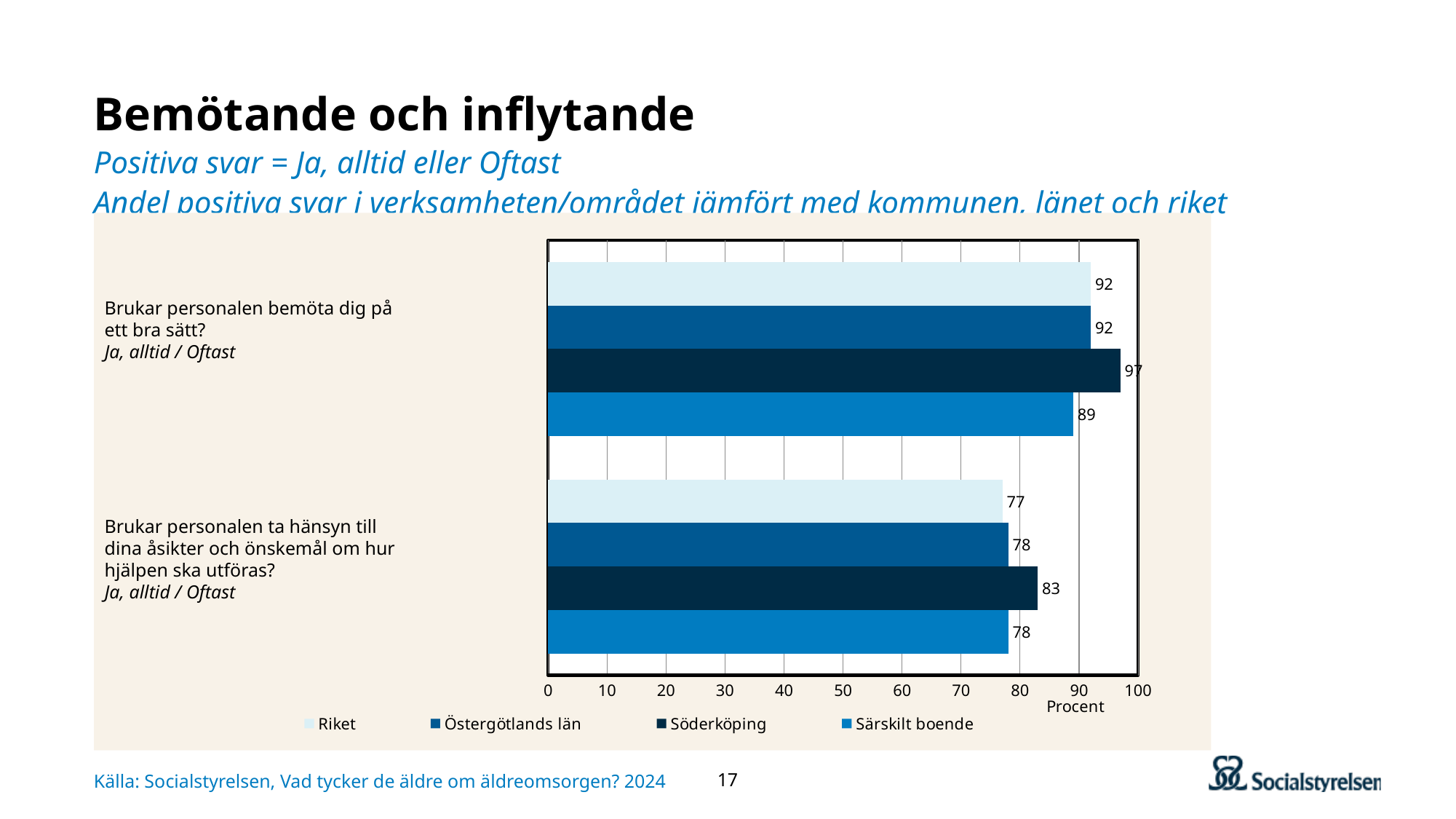
Which is larger on "Brukar personalen ta hänsyn till dina åsikter och önskemål om hur hjälpen ska utföras?": Söderköping or Östergötlands län? Söderköping What is the value for Söderköping on "Brukar personalen bemöta dig på ett bra sätt?" 97 Which series has the highest value on "Brukar personalen bemöta dig på ett bra sätt?" Söderköping What is the value for Riket on "Brukar personalen ta hänsyn till dina åsikter och önskemål om hur hjälpen ska utföras?" 77 What unit is shown on the x axis of the chart? Procent What is the value for Söderköping on "Brukar personalen ta hänsyn till dina åsikter och önskemål om hur hjälpen ska utföras?" 83 Which series has the lowest value on "Brukar personalen bemöta dig på ett bra sätt?" Särskilt boende What kind of chart is shown on the slide? Bar chart What is the difference between Söderköping and Riket on "Brukar personalen ta hänsyn till dina åsikter och önskemål om hur hjälpen ska utföras?" 6 How many series does the legend list? 4 What is the difference between Söderköping and Särskilt boende on "Brukar personalen bemöta dig på ett bra sätt?" 8 What is the value for Särskilt boende on "Brukar personalen bemöta dig på ett bra sätt?" 89